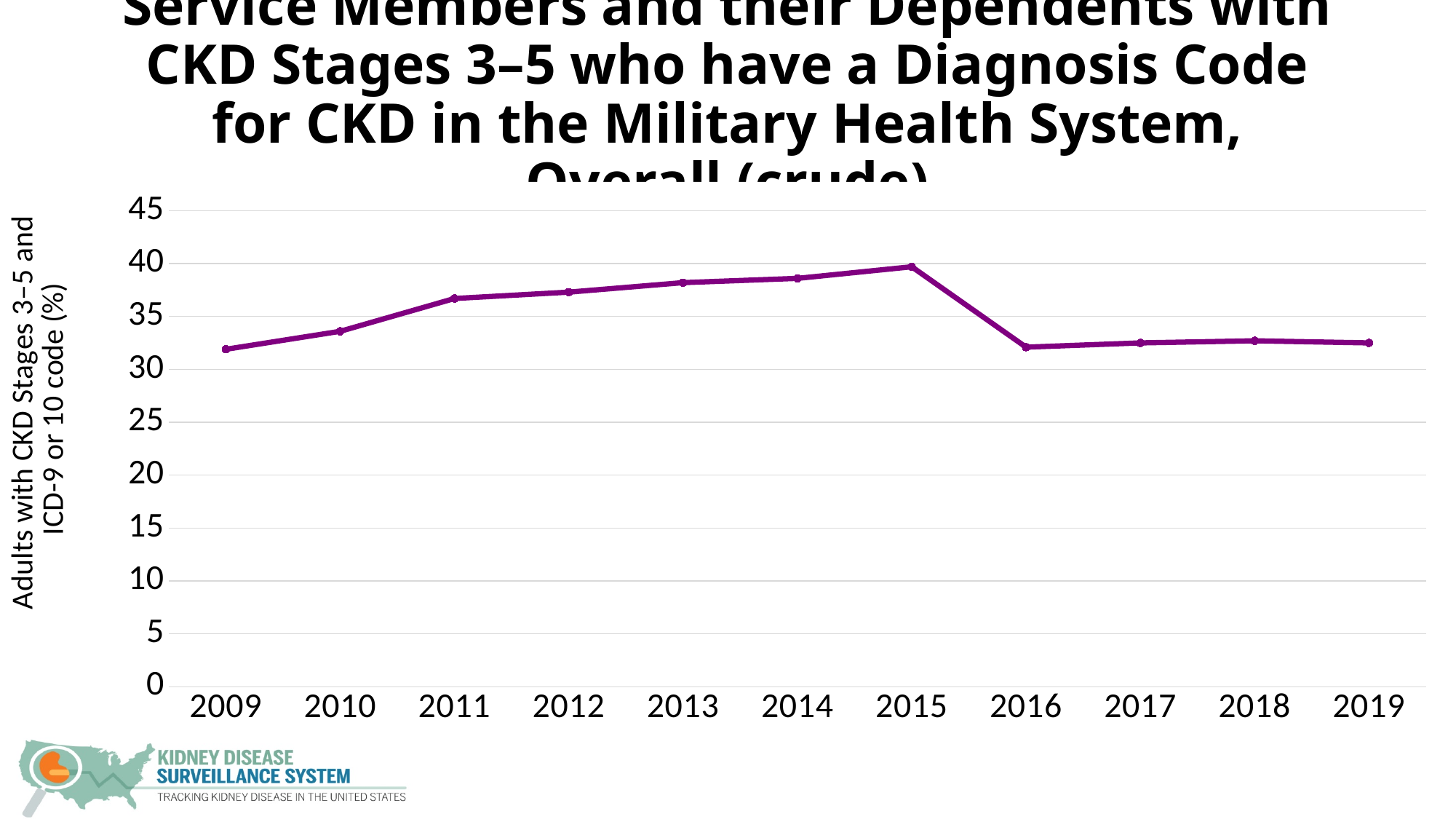
Is the value for 2015 greater or less than 35? greater Is the value for 2013 greater or less than 35? greater Which year has the larger value, 2010 or 2011? 2011 What kind of chart is shown on the slide? line chart Is the value for 2014 greater or less than 40? less What is the label on the y axis? Adults with CKD Stages 3–5 and ICD-9 or 10 code (%) Which year has the highest value? 2015 How many years are plotted along the x axis? 11 Which year has the larger value, 2015 or 2016? 2015 Do the values rise or fall from 2009 to 2015? rise